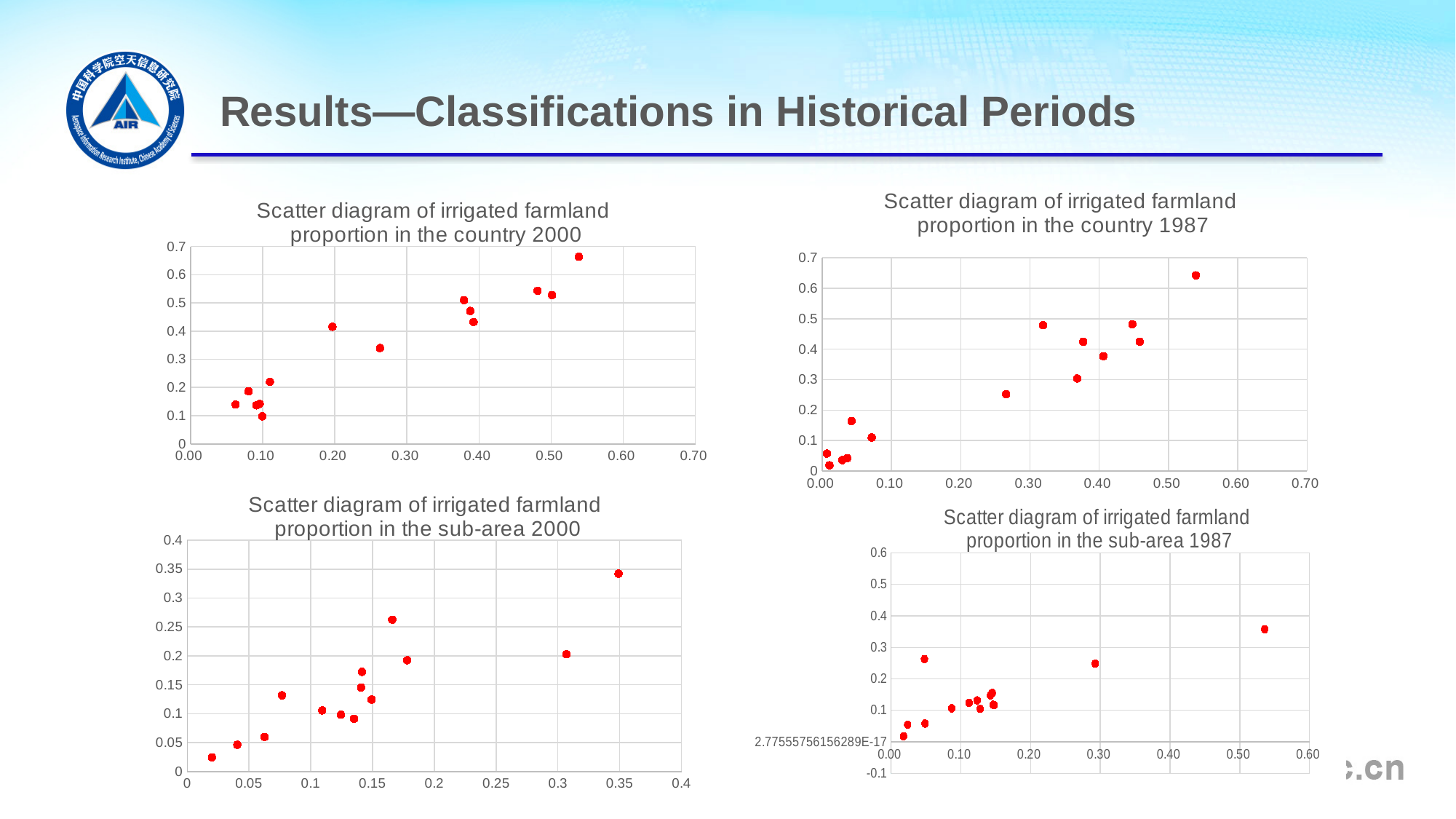
In the 'Scatter diagram of irrigated farmland proportion in the sub-area 1987', is the y value of the highest point greater or less than 0.4? less In the 'Scatter diagram of irrigated farmland proportion in the sub-area 1987', is the y value of the point at x = 0.30 greater or less than 0.2? greater In the 'Scatter diagram of irrigated farmland proportion in the sub-area 2000', is the y value of the highest point greater or less than 0.3? greater How many charts are shown on the slide? 4 What is the maximum value shown on the y axis of the 'Scatter diagram of irrigated farmland proportion in the sub-area 2000'? 0.4 In the 'Scatter diagram of irrigated farmland proportion in the country 1987', do the y values generally rise or fall as x increases? Rise In the 'Scatter diagram of irrigated farmland proportion in the country 2000', do the y values generally rise or fall as x increases? Rise How many points are plotted in the 'Scatter diagram of irrigated farmland proportion in the sub-area 2000'? 14 In the 'Scatter diagram of irrigated farmland proportion in the sub-area 2000', do the y values generally rise or fall as x increases? Rise What kind of chart is the 'Scatter diagram of irrigated farmland proportion in the country 2000'? Scatter chart